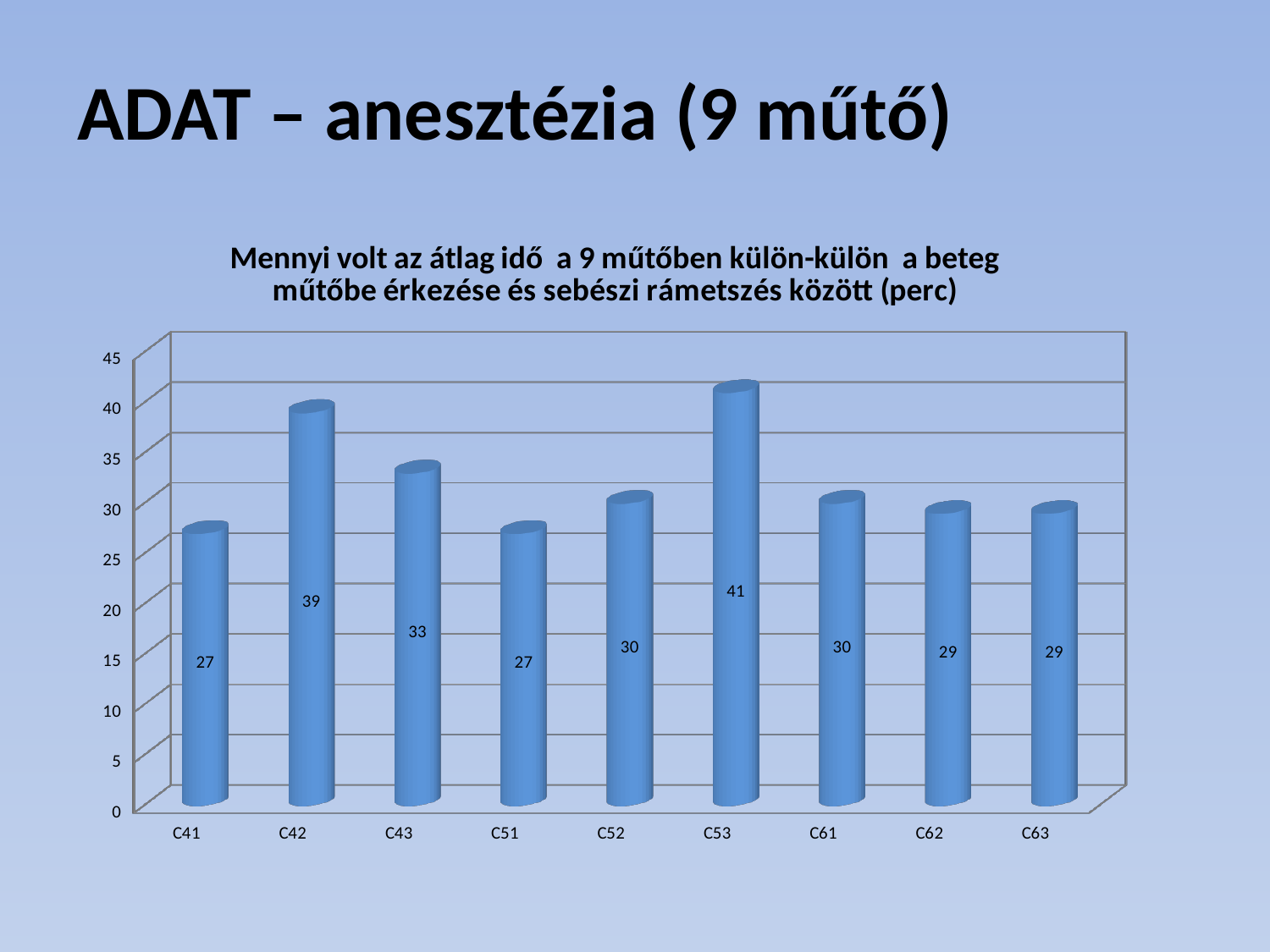
Which category has the highest value? C53 What is the difference between the values for C42 and C43? 6 What is the value for C62? 29 What is the value for C51? 27 What is the value for C42? 39 Is the value for C42 greater or less than 35? greater What is the difference between the values for C53 and C41? 14 What kind of chart is shown on the slide? bar chart How many categories are shown on the x axis? 9 What is the value for C53? 41 Which is larger, the value for C43 or the value for C52? C43 What unit is given in parentheses at the end of the chart title? perc